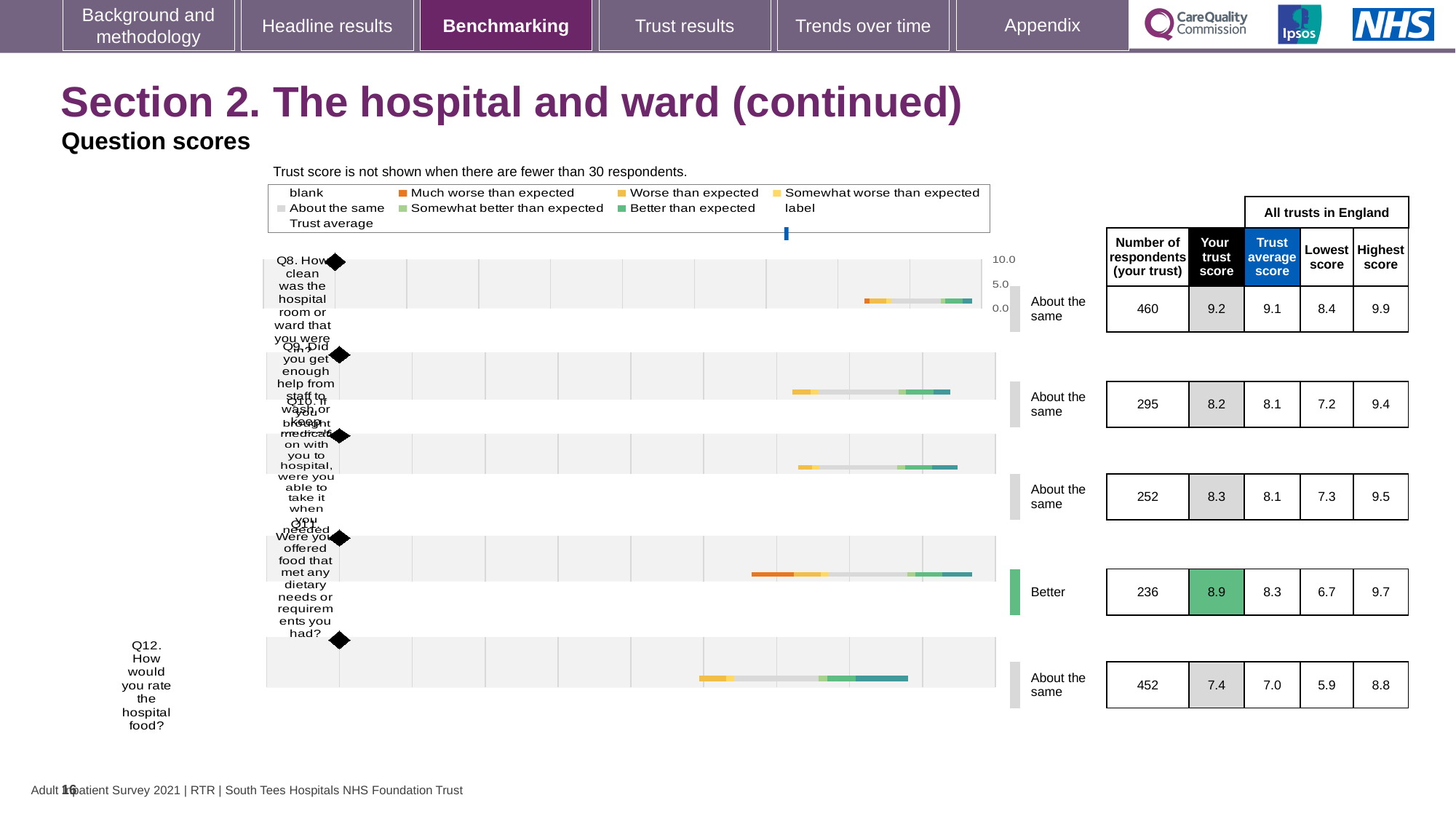
How many questions (rows) are plotted in the question scores chart? 5 Which has the higher trust score, Q9 or Q10? Q10 For Q11, what is the difference between the trust score and the trust average score? 0.6 What is the lowest score across all trusts in England for Q10? 7.3 What benchmark category is shown for Q11 (Were you offered food that met any dietary needs)? Better What kind of chart is used to show the question scores on this slide? Bar chart What is the highest score across all trusts in England for Q9? 9.4 How many respondents answered Q12 (How would you rate the hospital food)? 452 What is the trust score for Q8 (How clean was the hospital room or ward)? 9.2 According to the note above the chart, the trust score is not shown when there are fewer than how many respondents? 30 Which question has the lowest 'Your trust score'? Q12 Which question has the highest 'Your trust score'? Q8